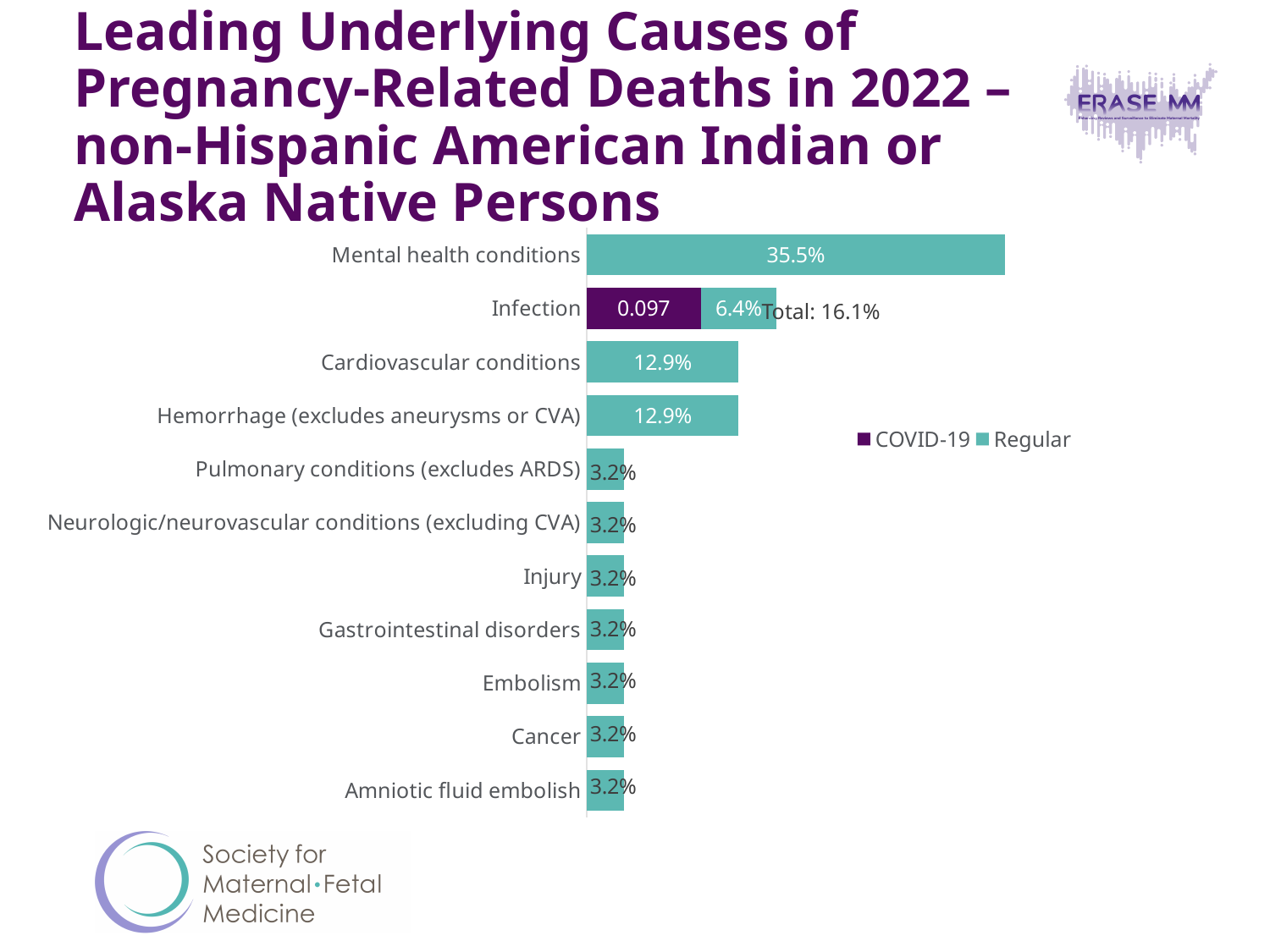
What is the Regular value for Infection? 6.4% How many categories are shown on the chart? 11 What total is printed next to the Infection bar? Total: 16.1% What is the COVID-19 value for Infection? 0.097 What is the value for Embolism? 3.2% Which is larger, the value for Hemorrhage (excludes aneurysms or CVA) or the value for Injury? Hemorrhage (excludes aneurysms or CVA) What is the difference between Mental health conditions and Cardiovascular conditions? 22.6% What is the value for Mental health conditions? 35.5% How many series does the legend list? 2 What kind of chart is shown on the slide? bar chart Which category has the highest value? Mental health conditions What is the value for Cardiovascular conditions? 12.9%